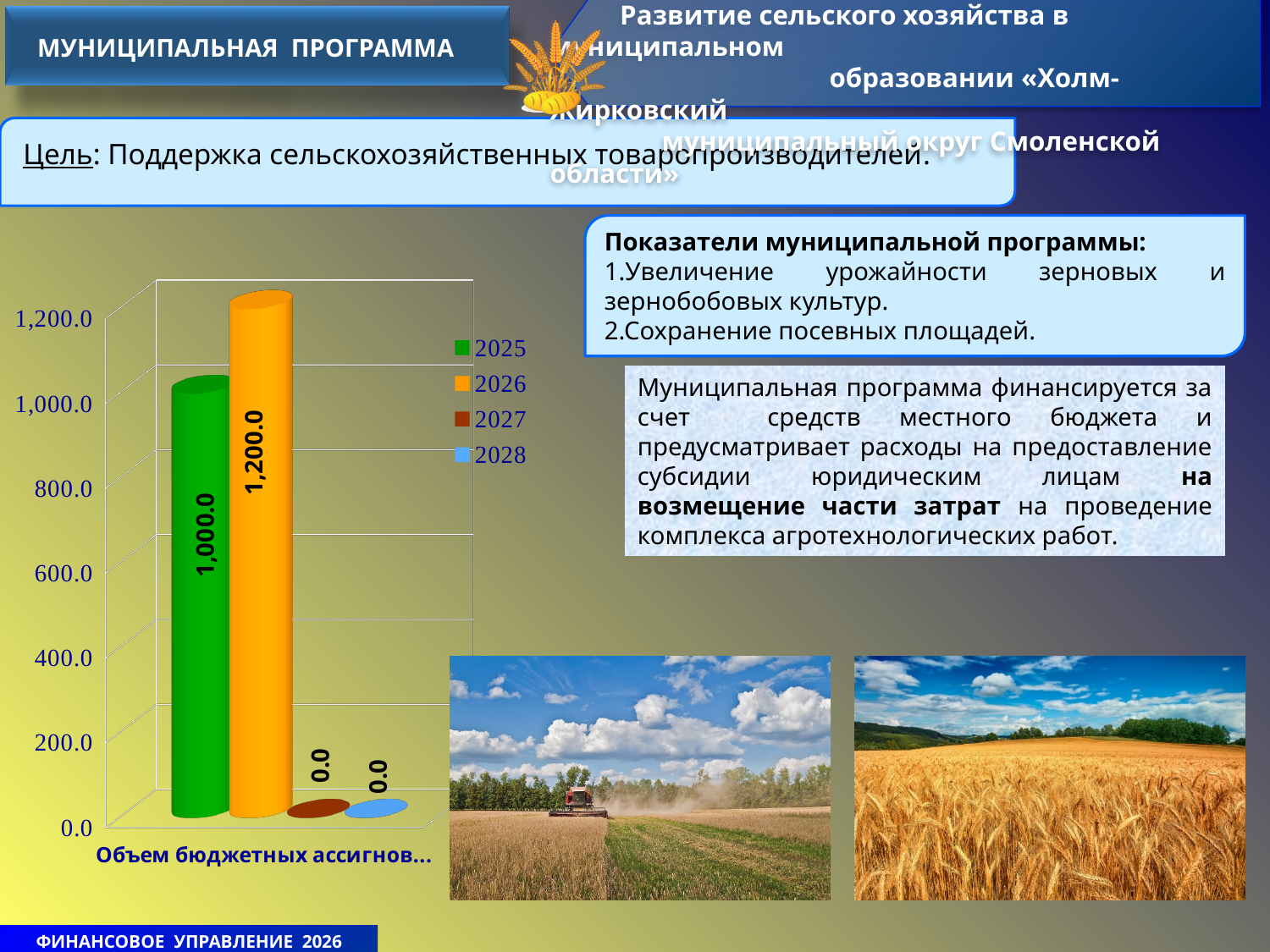
What is the value for 2027 in the chart? 0.0 Is the value for 2025 greater or less than 800.0? greater What is the value for 2025 in the chart? 1,000.0 Which years have a value of 0.0 in the chart? 2027 and 2028 What kind of chart is shown on the slide? bar chart What is the value for 2028 in the chart? 0.0 What is the value for 2026 in the chart? 1,200.0 Which year has the highest value in the chart? 2026 How many series does the legend list? 4 What colour is the bar for 2026 in the chart? orange Which is larger, the value for 2025 or the value for 2026? 2026 What is the difference between the values for 2026 and 2025? 200.0